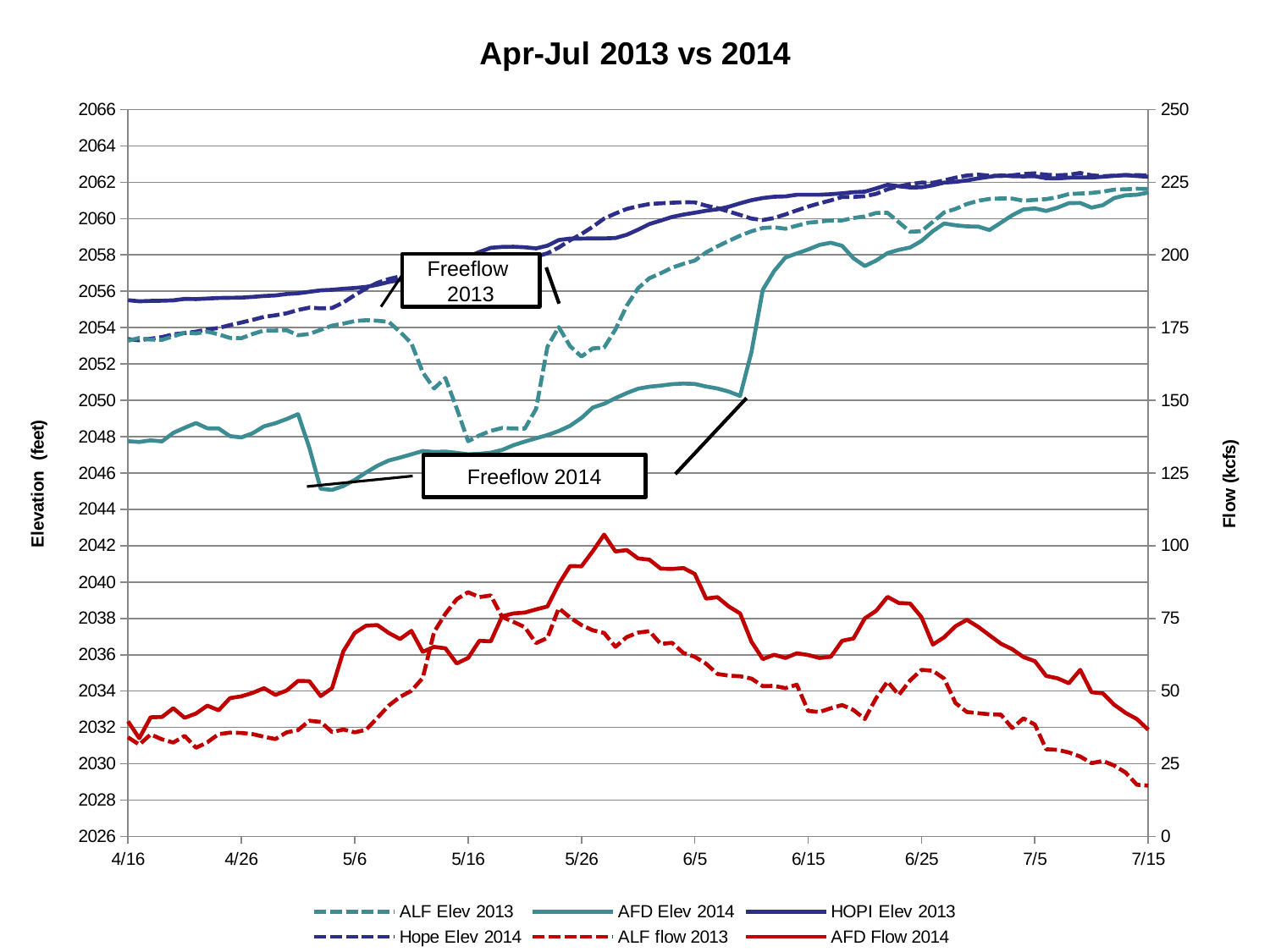
Is the value of AFD Elev 2014 on 4/16 greater or less than 2050 feet? less What kind of chart is shown on the slide? Line chart On 5/16, which series has the higher flow: ALF flow 2013 or AFD Flow 2014? ALF flow 2013 Does HOPI Elev 2013 generally rise or fall from 4/16 to 7/15? rise What is the label of the right-hand vertical axis? Flow (kcfs) On 7/15, which series is higher: HOPI Elev 2013 or AFD Elev 2014? HOPI Elev 2013 What is the title of the chart? Apr-Jul 2013 vs 2014 How many series does the legend list? 6 Is the value of HOPI Elev 2013 on 7/15 greater or less than 2060 feet? greater Is the peak value of AFD Flow 2014 greater or less than 75 kcfs? greater Does AFD Flow 2014 rise or fall from 6/25 to 7/15? fall